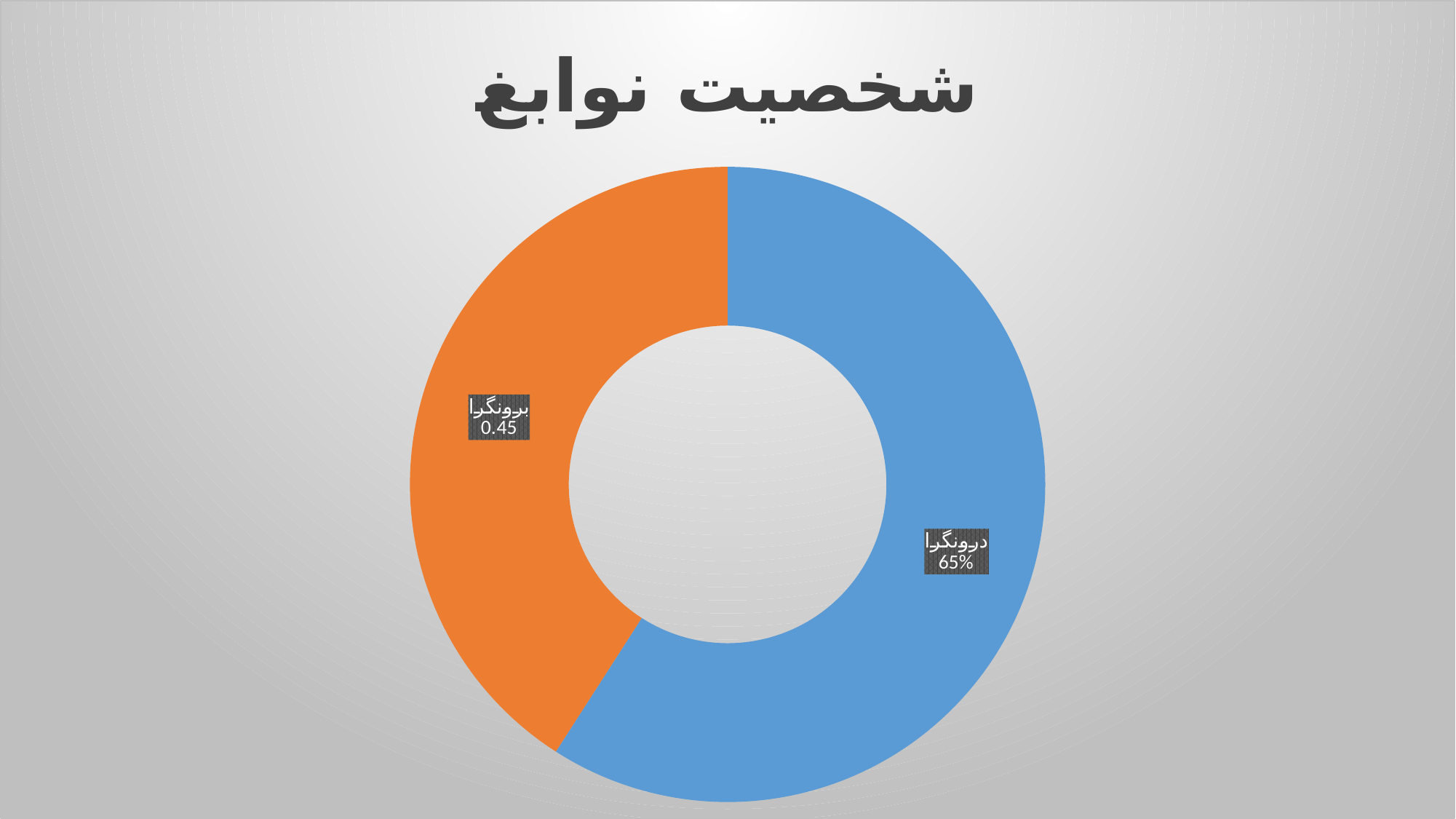
What kind of chart is shown on the slide? Doughnut chart What value is shown for درونگرا? 65% What colour is the درونگرا slice? Blue How many slices does the chart have? 2 What value is shown for برونگرا? 0.45 Which slice is the largest? درونگرا What is the title of the chart? شخصیت نوابغ Which slice is the smallest? برونگرا Which is larger, the slice for درونگرا or the slice for برونگرا? درونگرا